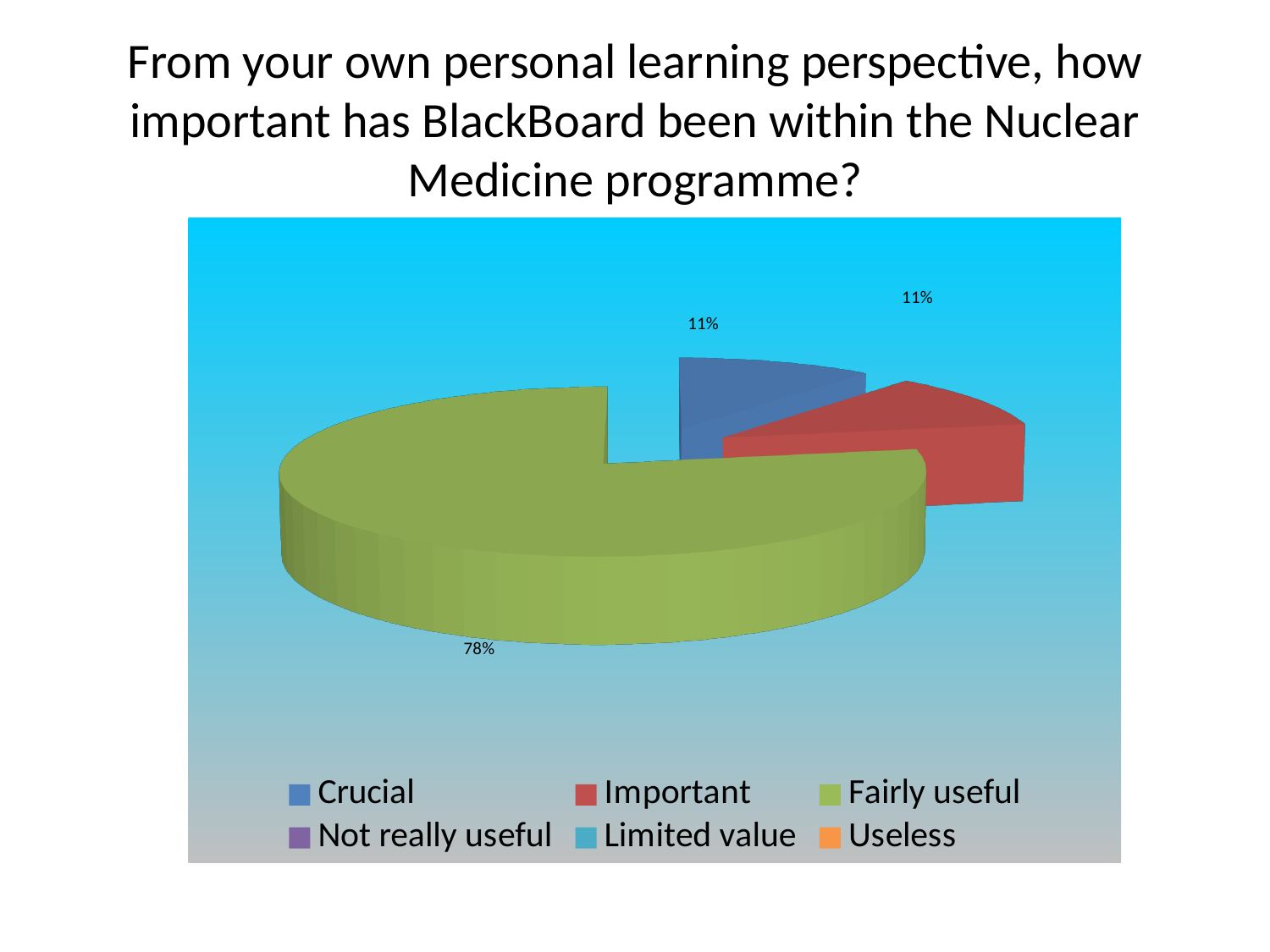
What percentage of respondents rated BlackBoard as 'Important'? 11% Do 'Crucial' and 'Important' have the same share of the pie? Yes, both 11% What colour is the 'Fairly useful' slice? Green How many slices with percentage labels are visible in the pie? 3 What percentage of respondents rated BlackBoard as 'Fairly useful'? 78% Which is larger, the share for 'Fairly useful' or the share for 'Important'? Fairly useful What do the three labelled slices (Crucial, Important, Fairly useful) add up to? 100% What percentage of respondents rated BlackBoard as 'Crucial'? 11% By how many percentage points does the 'Fairly useful' share exceed the 'Crucial' share? 67 percentage points What kind of chart is shown on the slide? Pie chart How many response categories does the legend list? 6 Which response category has the largest share of the pie? Fairly useful